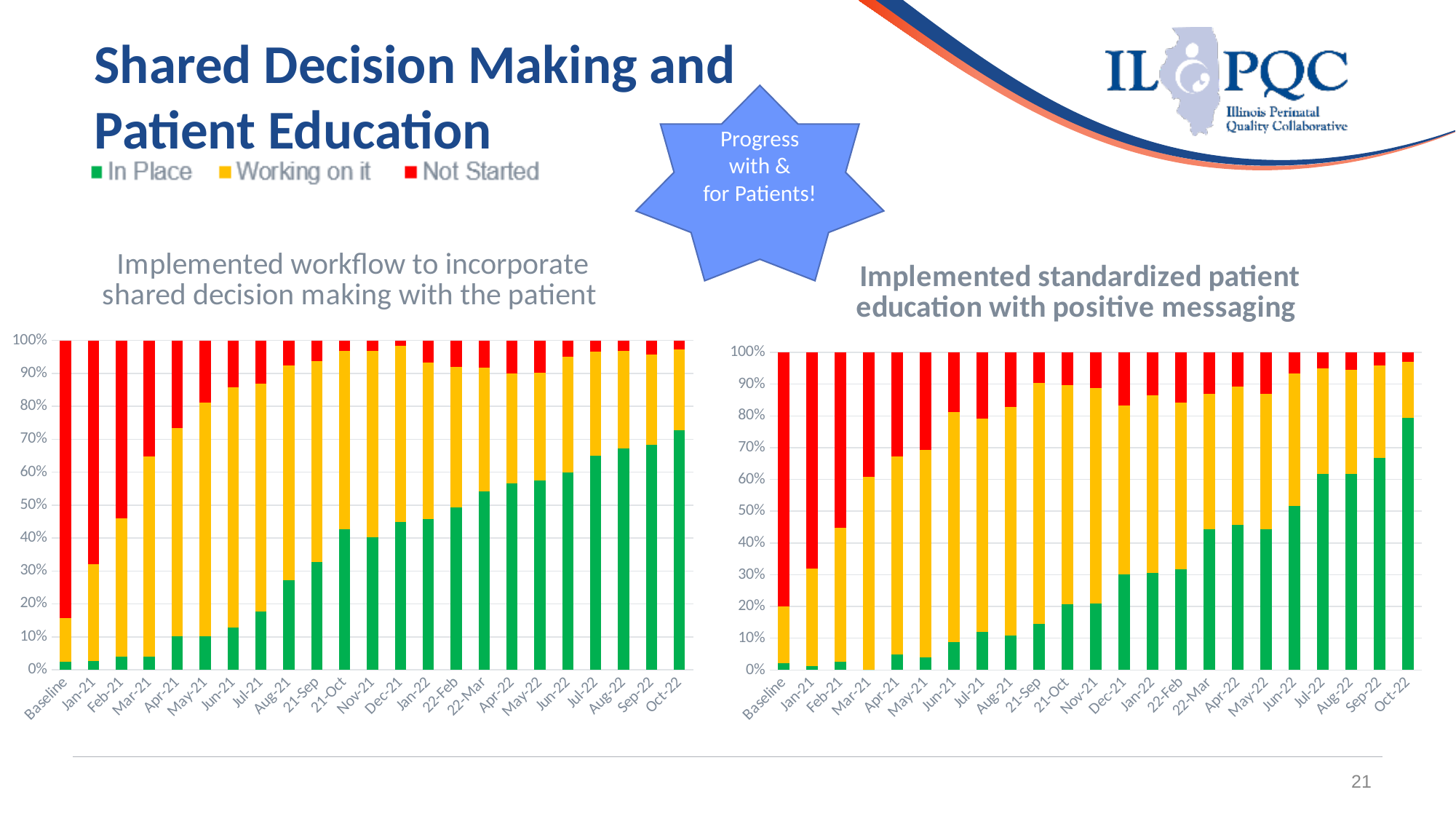
In the left chart, 'Implemented workflow to incorporate shared decision making with the patient', is the 'In Place' value for Baseline greater or less than 10%? less What kind of chart is the left chart, 'Implemented workflow to incorporate shared decision making with the patient'? Stacked bar chart Which colour represents 'Not Started' in the legend? Red In the right chart, 'Implemented standardized patient education with positive messaging', is the 'Not Started' share for Baseline greater or less than 70%? greater In the right chart, 'Implemented standardized patient education with positive messaging', is the 'In Place' value for Oct-22 greater or less than 70%? greater In the left chart, 'Implemented workflow to incorporate shared decision making with the patient', which period has the highest 'In Place' value? Oct-22 How many series does the legend list for the charts on this slide? 3 In the right chart, 'Implemented standardized patient education with positive messaging', how many time-period categories are shown on the x axis? 23 In the left chart, 'Implemented workflow to incorporate shared decision making with the patient', how many time-period categories are shown on the x axis? 23 In the right chart, 'Implemented standardized patient education with positive messaging', which period has the highest 'In Place' value? Oct-22 In the left chart, 'Implemented workflow to incorporate shared decision making with the patient', does the 'In Place' share generally rise or fall from Baseline to Oct-22? Rise